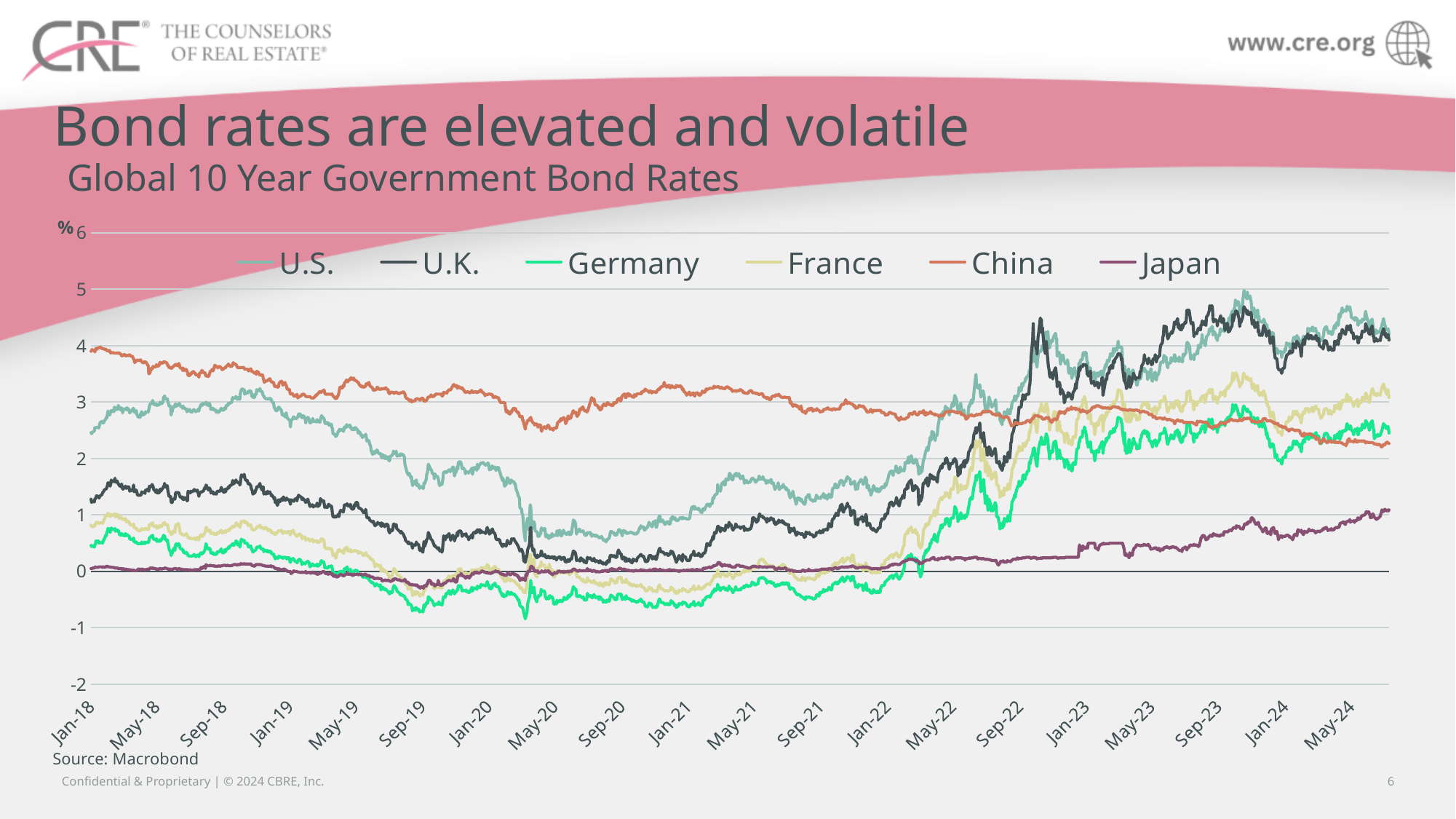
What source is cited for the chart? Macrobond Which series has the lowest value at Jan-18? Japan Which series has the lowest value at the right end of the chart (May-24)? Japan At Jan-18, which is higher, China or the U.S.? China Which series has the highest value at Jan-18? China Is the value for China at Jan-18 greater or less than 3? greater Is the value for Germany around Sep-19 greater or less than 0? less Is the value for the U.S. at the right end of the chart greater or less than 4? greater What kind of chart is shown on the slide? line chart What is the title of the chart? Global 10 Year Government Bond Rates Does the China line rise or fall overall from Jan-18 to May-24? fall How many series does the chart's legend list? 6